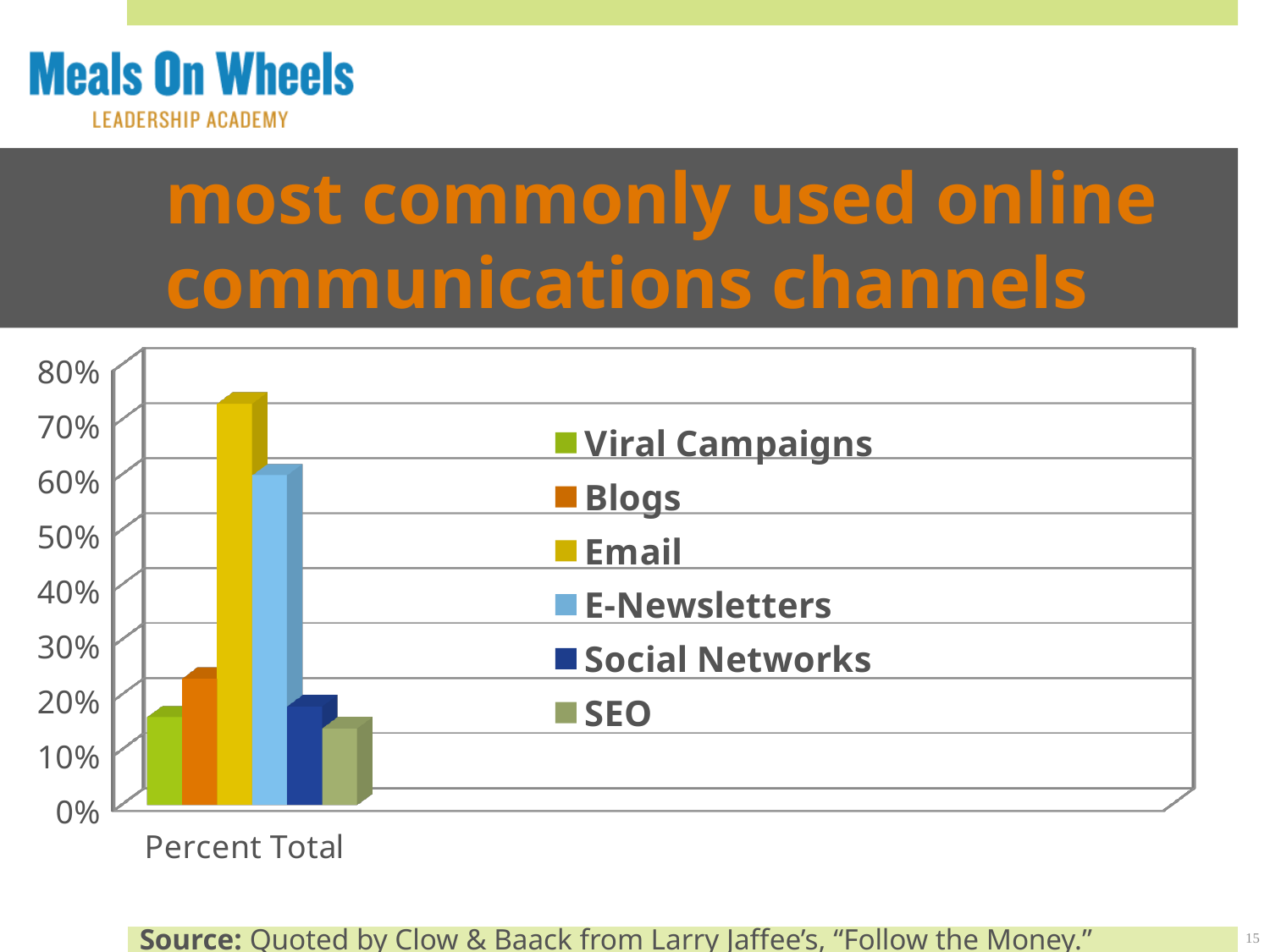
What kind of chart is shown on the slide? Bar chart Is the value for Viral Campaigns greater or less than 20%? less Which is larger, the value for Blogs or the value for Viral Campaigns? Blogs Which series has the highest value? Email Is the value for E-Newsletters greater or less than 50%? greater Is the value for Email greater or less than 60%? greater What is the label shown under the group of bars on the x axis? Percent Total Which is larger, the value for Email or the value for E-Newsletters? Email What is the title of the slide above the chart? most commonly used online communications channels How many series does the legend list? 6